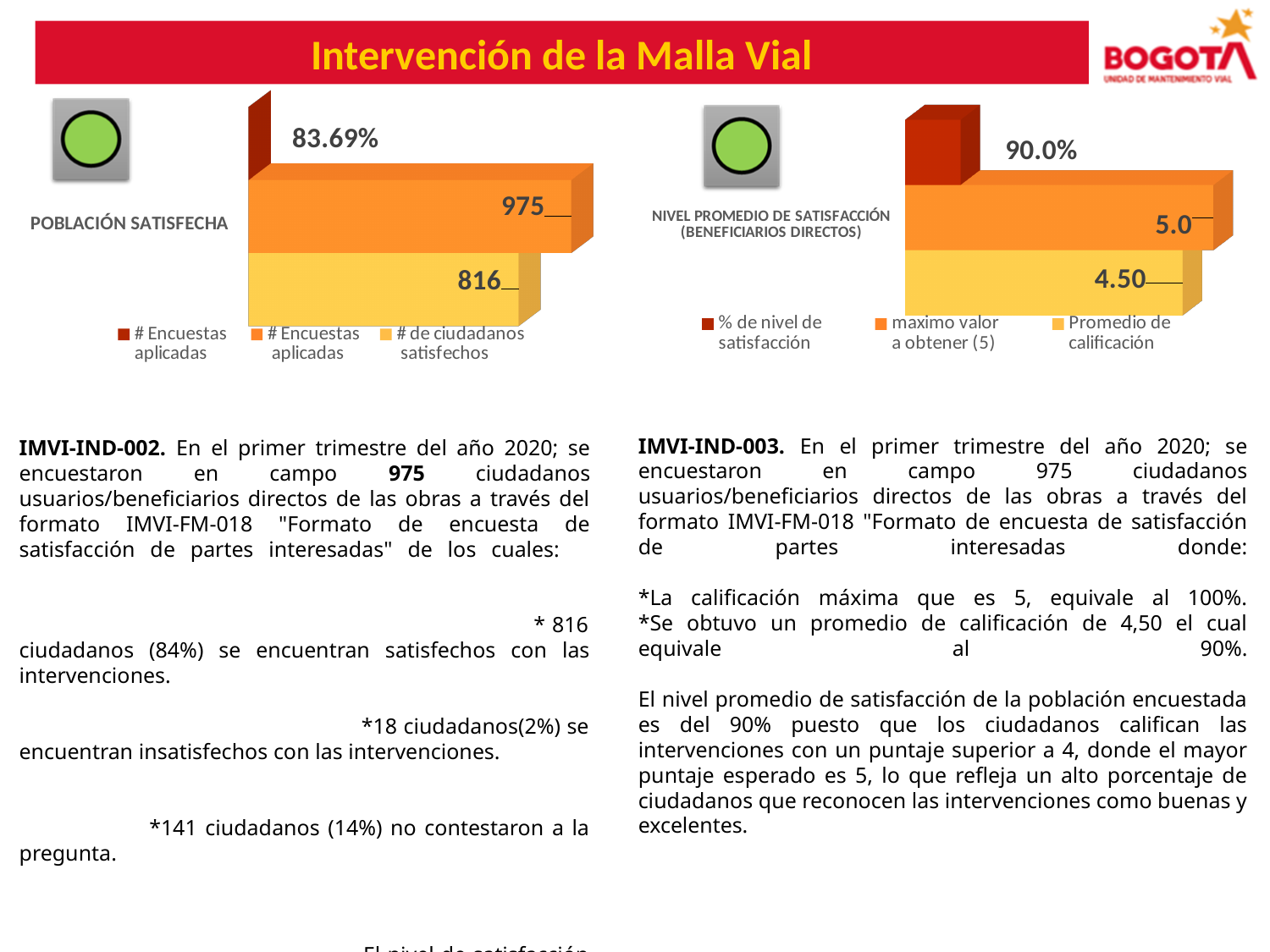
In the right chart (NIVEL PROMEDIO DE SATISFACCIÓN), what value is shown for 'maximo valor a obtener (5)'? 5.0 In the left chart (POBLACIÓN SATISFECHA), what is the difference between the orange bar value (975) and the '# de ciudadanos satisfechos' value? 159 In the left chart (POBLACIÓN SATISFECHA), which is larger: the orange bar value or the '# de ciudadanos satisfechos' value? The orange bar value (975) In the right chart (NIVEL PROMEDIO DE SATISFACCIÓN), what value is shown for 'Promedio de calificación'? 4.50 In the left chart (POBLACIÓN SATISFECHA), what percentage is labelled on the dark red bar? 83.69% In the right chart (NIVEL PROMEDIO DE SATISFACCIÓN), what is the difference between 'maximo valor a obtener (5)' and 'Promedio de calificación'? 0.50 In the right chart (NIVEL PROMEDIO DE SATISFACCIÓN), what value is shown for '% de nivel de satisfacción'? 90.0% What kind of chart is the left chart (POBLACIÓN SATISFECHA)? Bar chart In the left chart (POBLACIÓN SATISFECHA), what value is shown for '# de ciudadanos satisfechos'? 816 In the left chart (POBLACIÓN SATISFECHA), what value is labelled on the orange bar? 975 How many series does the legend of the right chart (NIVEL PROMEDIO DE SATISFACCIÓN) list? 3 How many series does the legend of the left chart (POBLACIÓN SATISFECHA) list? 3